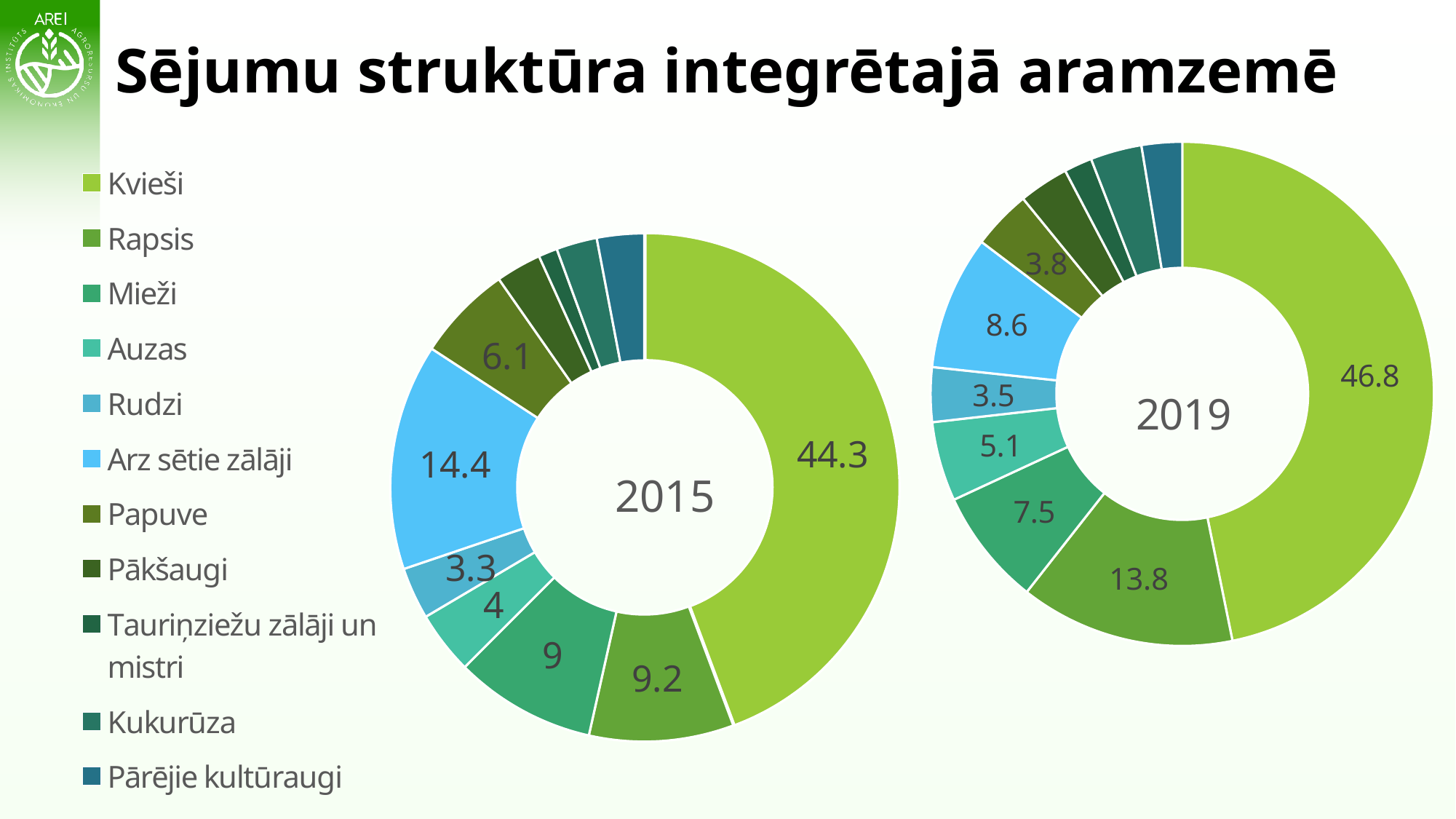
In the 2019 chart, what is the value for Rapsis? 13.8 In the 2015 chart, which is larger, Rapsis or Mieži? Rapsis What kind of chart is used on this slide? Doughnut (pie) chart In the 2019 chart, what is the value for Papuve? 3.8 In the 2015 chart, what is the value for Kvieši? 44.3 In the 2015 chart, what is the value for Rudzi? 3.3 In the 2015 chart, what is the difference between Arz sētie zālāji and Papuve? 8.3 What is the difference between the Kvieši value in the 2019 chart and the Kvieši value in the 2015 chart? 2.5 In the 2019 chart, which is larger, Arz sētie zālāji or Mieži? Arz sētie zālāji In the 2015 chart, what is the value for Arz sētie zālāji? 14.4 How many categories does the legend list? 11 In the 2019 chart, which category has the largest slice? Kvieši